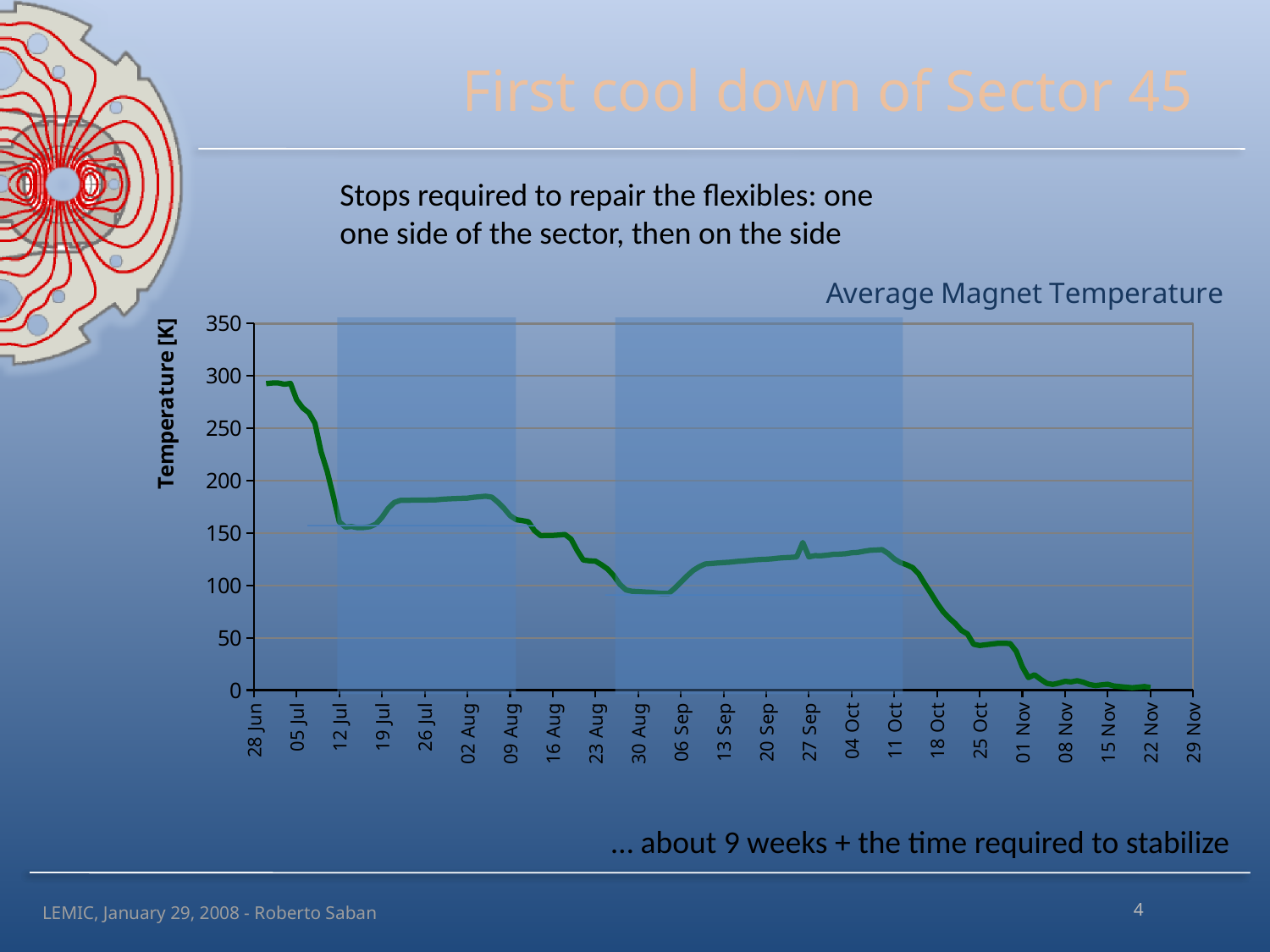
What is the title of the chart? Average Magnet Temperature Is the value for 04 Oct greater or less than 100? greater Which has the higher average magnet temperature, 28 Jun or 22 Nov? 28 Jun Is the value for 26 Jul greater or less than 150? greater Is the value for 30 Aug greater or less than 150? less Which has the higher average magnet temperature, 26 Jul or 30 Aug? 26 Jul Overall, does the average magnet temperature rise or fall from 28 Jun to 22 Nov? Fall What is the label of the vertical axis of the chart? Temperature [K] What kind of chart is shown on the slide? Line chart